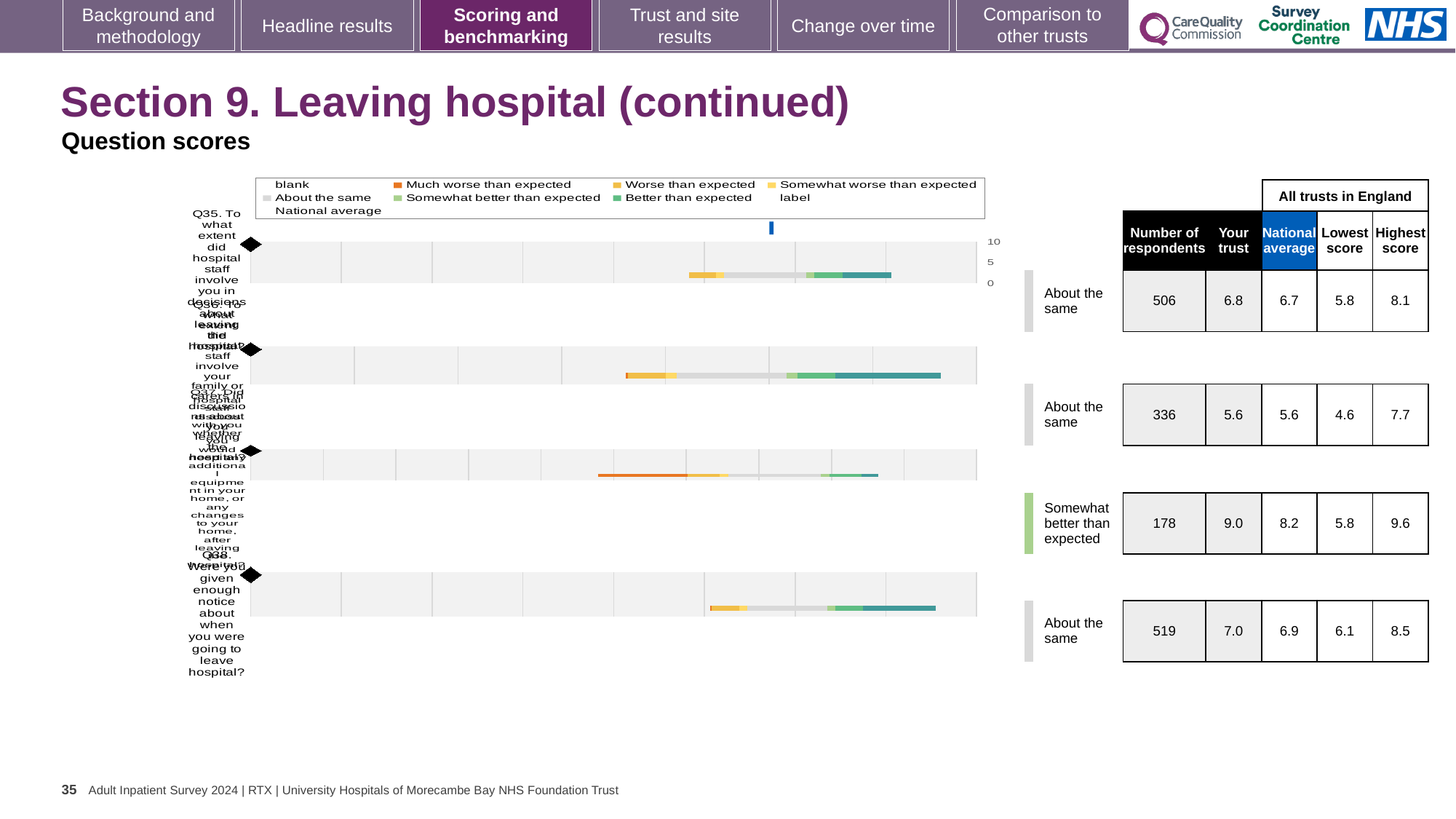
Which benchmark category is Q37 placed in? Somewhat better than expected What is the difference between the trust score and the national average for Q37? 0.8 For Q35, which is larger: the trust score or the national average? the trust score (6.8) What is the 'Your trust' score for Q38 (Were you given enough notice about when you were going to leave hospital?)? 7.0 Which question has the highest 'Your trust' score? Q37 What is the highest score across all trusts in England for Q37? 9.6 What is the national average score for Q35 (To what extent did hospital staff involve you in decisions about leaving the hospital?)? 6.7 What kind of chart is used to show the question scores on this slide? bar chart How many questions (rows) are plotted in the question scores chart? 4 How many of the four questions are rated 'About the same'? 3 Which question has the lowest 'Your trust' score? Q36 How many respondents answered Q37? 178